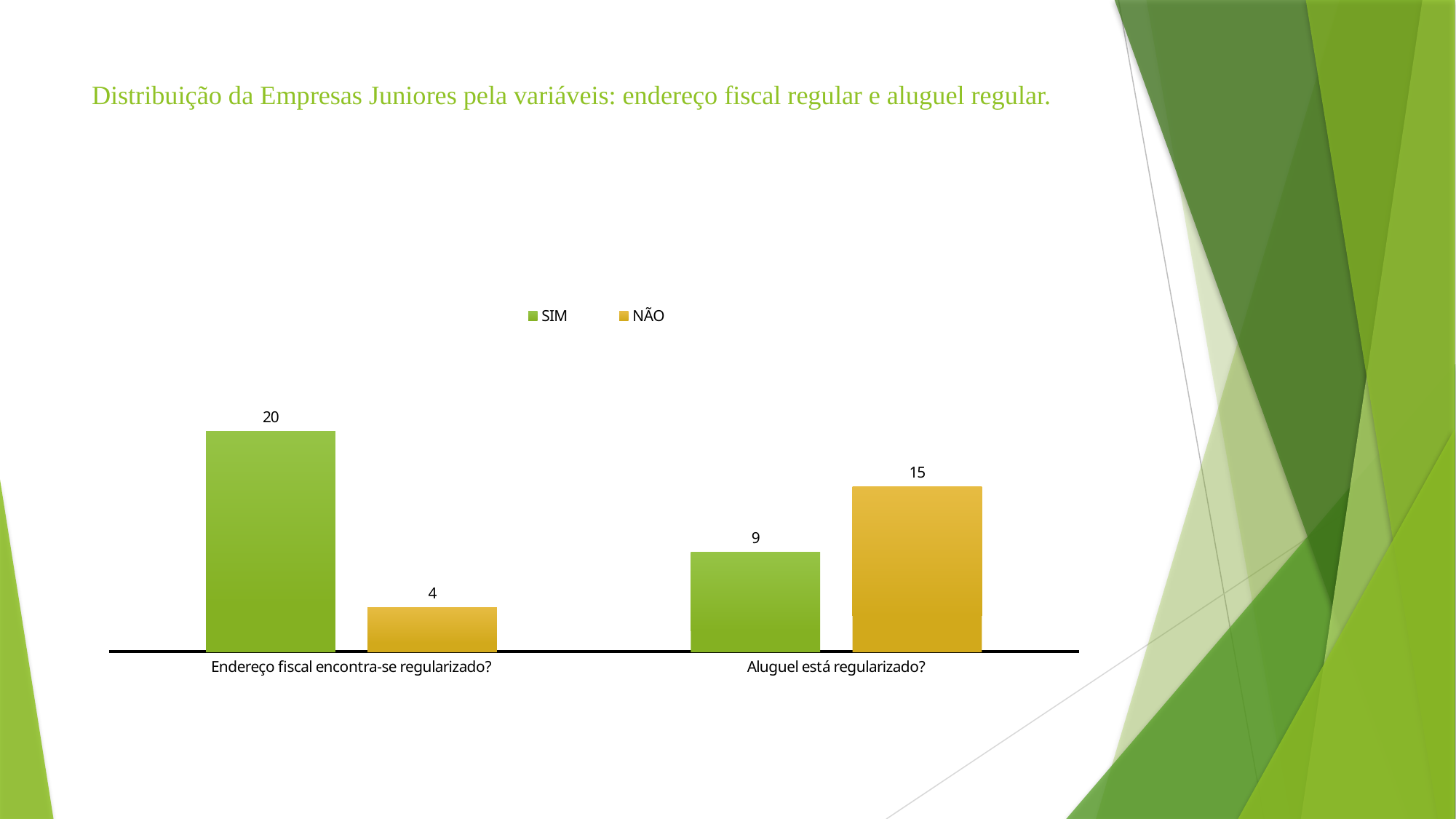
What is the difference between the NÃO and SIM values for "Aluguel está regularizado?"? 6 What is the NÃO value for "Endereço fiscal encontra-se regularizado?"? 4 What kind of chart is shown on the slide? Bar chart For "Aluguel está regularizado?", which is larger, SIM or NÃO? NÃO What is the SIM value for "Aluguel está regularizado?"? 9 How many series does the legend list? 2 How many categories are shown on the x axis? 2 Which bar has the highest value on the chart? SIM for Endereço fiscal encontra-se regularizado? What is the difference between the SIM and NÃO values for "Endereço fiscal encontra-se regularizado?"? 16 What is the NÃO value for "Aluguel está regularizado?"? 15 Which bar has the lowest value on the chart? NÃO for Endereço fiscal encontra-se regularizado? What is the SIM value for "Endereço fiscal encontra-se regularizado?"? 20